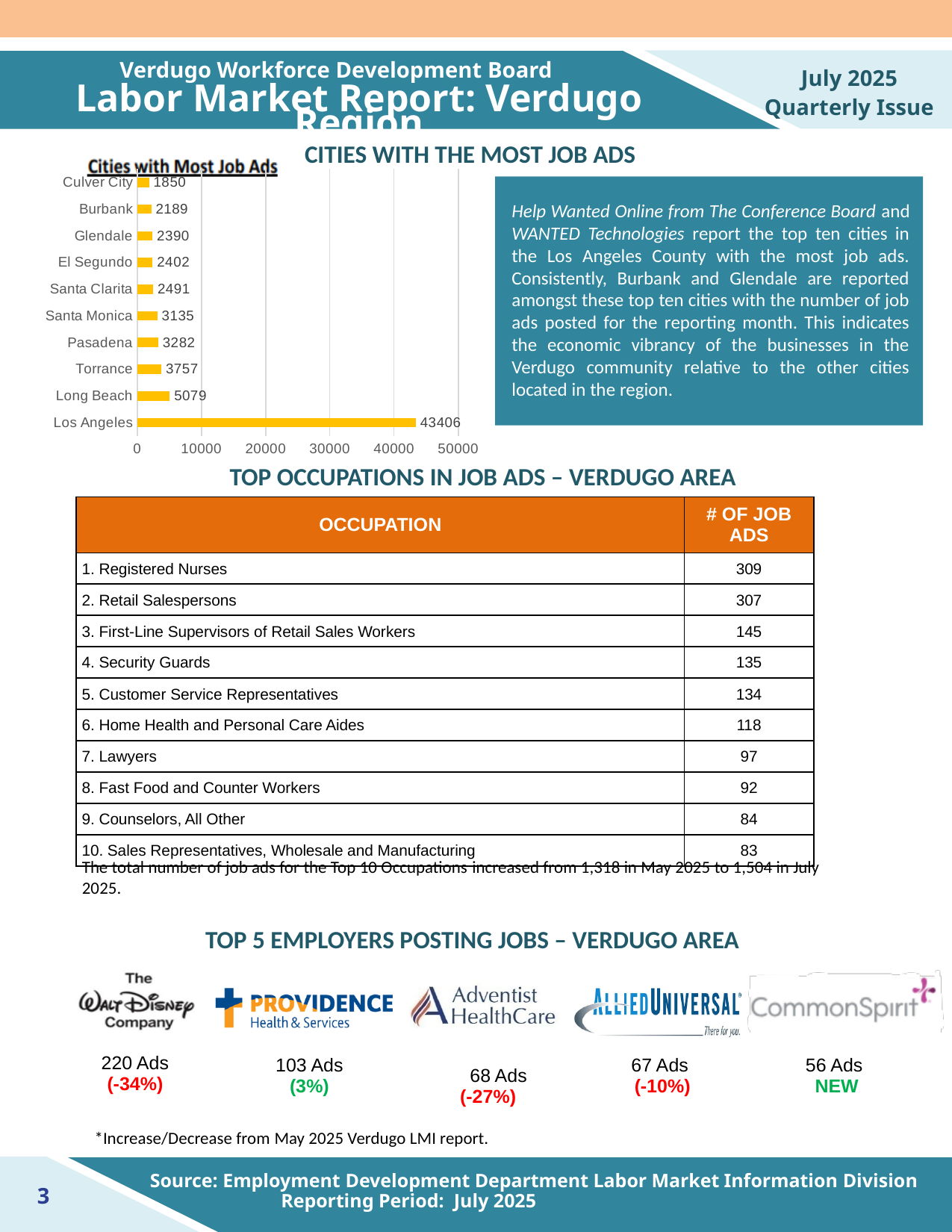
How many cities are shown in the Cities with Most Job Ads chart? 10 In the Cities with Most Job Ads chart, what is the difference in job ads between Glendale and Burbank? 201 In the Cities with Most Job Ads chart, how many job ads are shown for Long Beach? 5079 In the Cities with Most Job Ads chart, is the value for Los Angeles greater or less than 40000? greater In the Cities with Most Job Ads chart, how many job ads are shown for Glendale? 2390 In the Cities with Most Job Ads chart, which city has the most job ads? Los Angeles In the Cities with Most Job Ads chart, which city has more job ads, Pasadena or Santa Monica? Pasadena In the Cities with Most Job Ads chart, which city has the fewest job ads? Culver City In the Cities with Most Job Ads chart, what is the difference in job ads between Long Beach and Torrance? 1322 In the Cities with Most Job Ads chart, how many job ads are shown for Los Angeles? 43406 In the Cities with Most Job Ads chart, how many job ads are shown for Burbank? 2189 What type of chart is the Cities with Most Job Ads chart? Bar chart